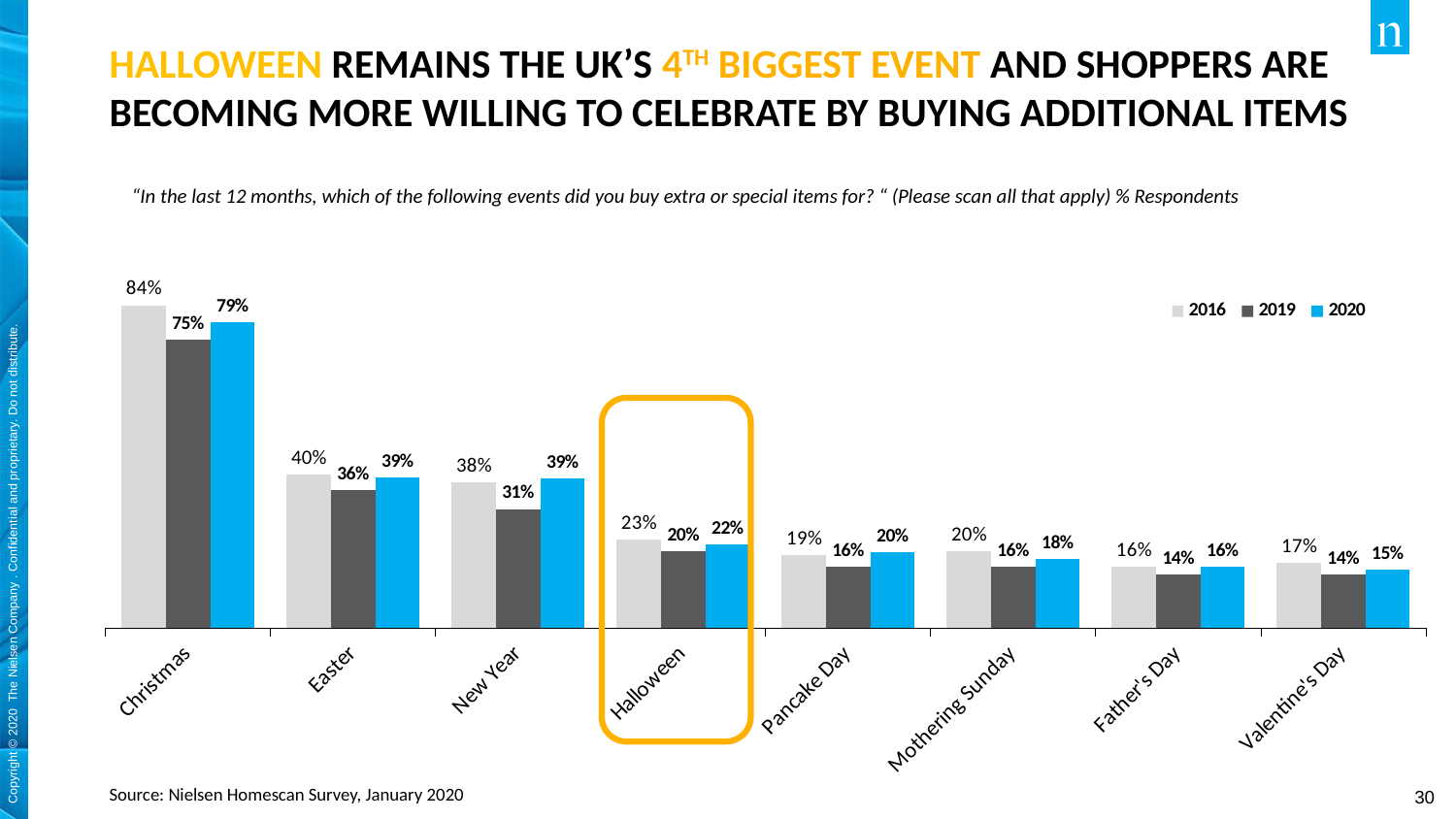
What is the difference between the 2016 and 2020 values for Christmas? 5% Which is larger: the 2020 value for Easter or the 2020 value for Halloween? Easter What is the 2016 value for Christmas? 84% Which event has the highest 2020 value? Christmas What is the 2019 value for New Year? 31% Which event has the lowest 2019 value? Father's Day and Valentine's Day (both 14%) What is the 2020 value for Halloween? 22% How many series does the legend list? 3 Which event is highlighted with an orange outline on the chart? Halloween What kind of chart is shown on the slide? Bar chart How many events are shown on the x axis? 8 What is the difference between the 2019 and 2020 values for New Year? 8%